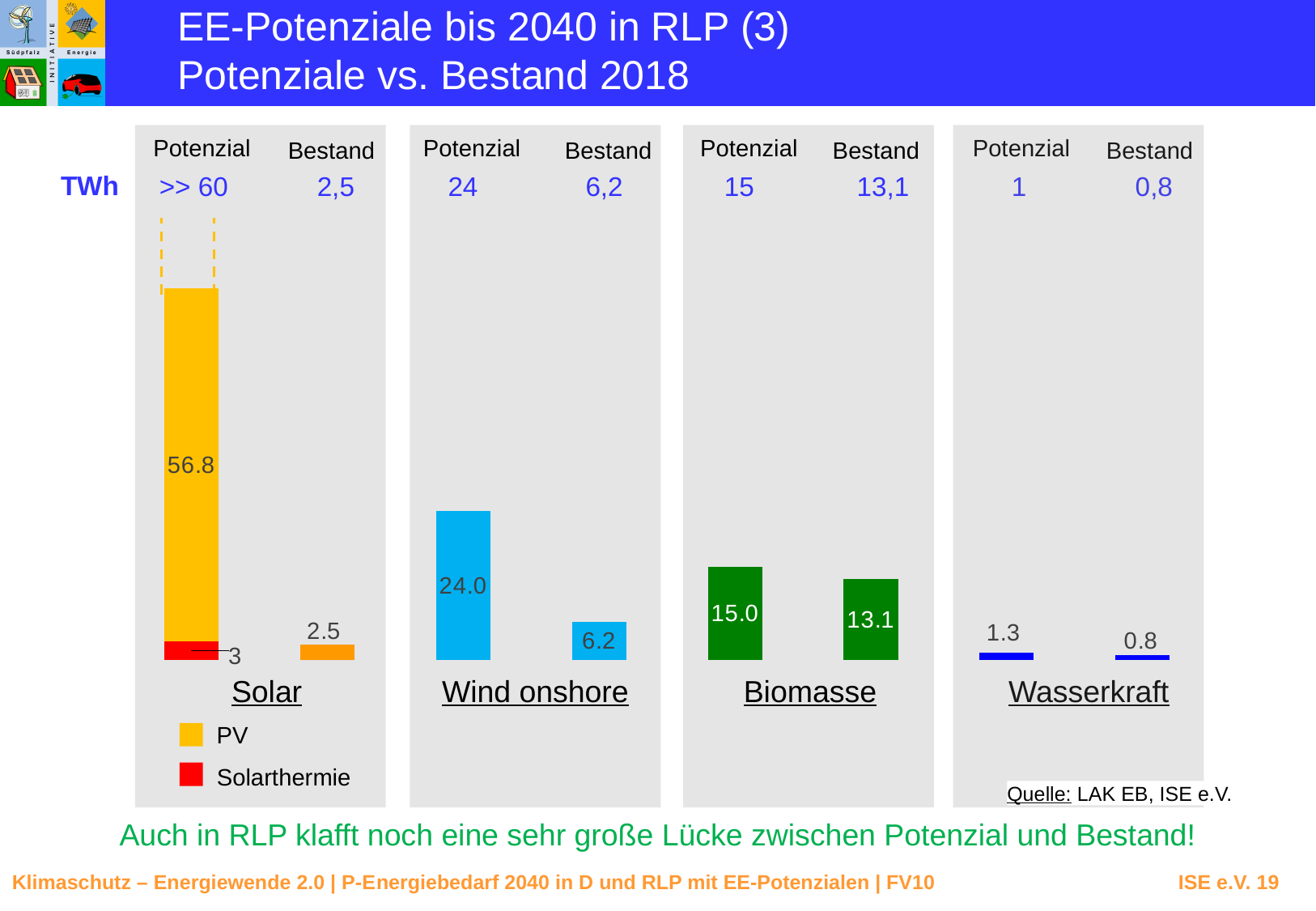
In the Wind onshore chart, what is the value of the Bestand bar? 6.2 How many entries does the legend in the Solar chart list? 2 In the Solar chart, what is the data label on the PV portion of the Potenzial bar? 56.8 What kind of chart is used in the Wind onshore panel? Bar chart In the Wasserkraft chart, what is the value of the Potenzial bar? 1.3 In the Wasserkraft chart, which bar is larger, Potenzial or Bestand? Potenzial Across the four charts, which energy source has the lowest Bestand bar? Wasserkraft Across the four charts, which energy source has the highest Potenzial bar? Solar In the Biomasse chart, what is the difference between the Potenzial bar (15.0) and the Bestand bar (13.1)? 1.9 In the Wind onshore chart, what is the difference between the Potenzial bar (24.0) and the Bestand bar (6.2)? 17.8 In the Biomasse chart, what is the value of the Potenzial bar? 15.0 In the Solar chart, what is the value of the Bestand bar? 2.5